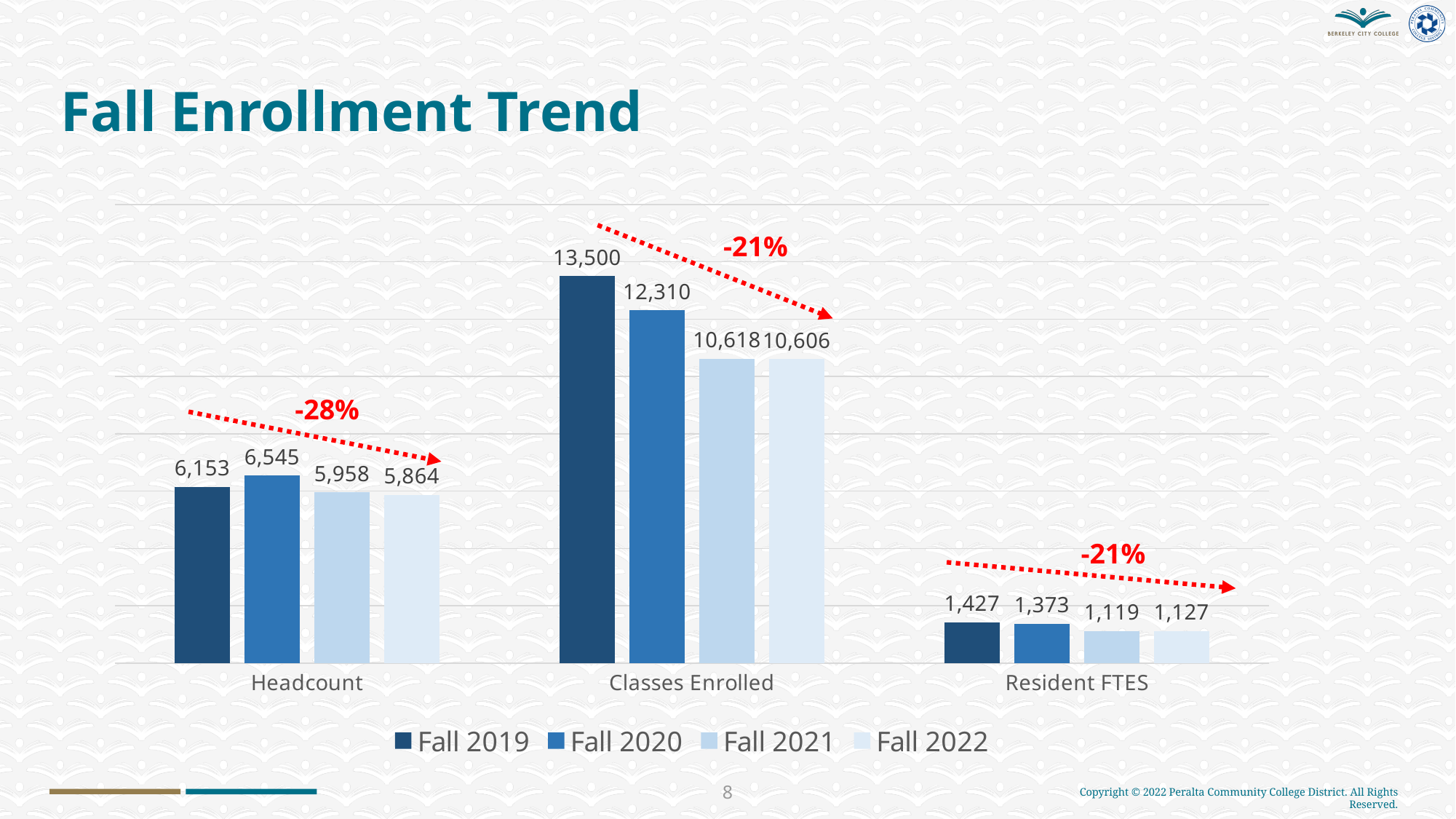
What is the Classes Enrolled value for Fall 2022? 10,606 Which series has the lowest Classes Enrolled value? Fall 2022 How many categories are shown on the x axis? 3 What is the difference between the Classes Enrolled values for Fall 2019 and Fall 2020? 1,190 What is the Resident FTES value for Fall 2021? 1,119 What kind of chart is shown on the slide? Bar chart What percentage change is annotated above the Classes Enrolled bars? -21% What is the Headcount value for Fall 2019? 6,153 What is the difference between the Headcount values for Fall 2020 and Fall 2022? 681 How many series does the legend list? 4 Which is larger: the Resident FTES value for Fall 2019 or for Fall 2020? Fall 2019 Which series has the highest Headcount value? Fall 2020